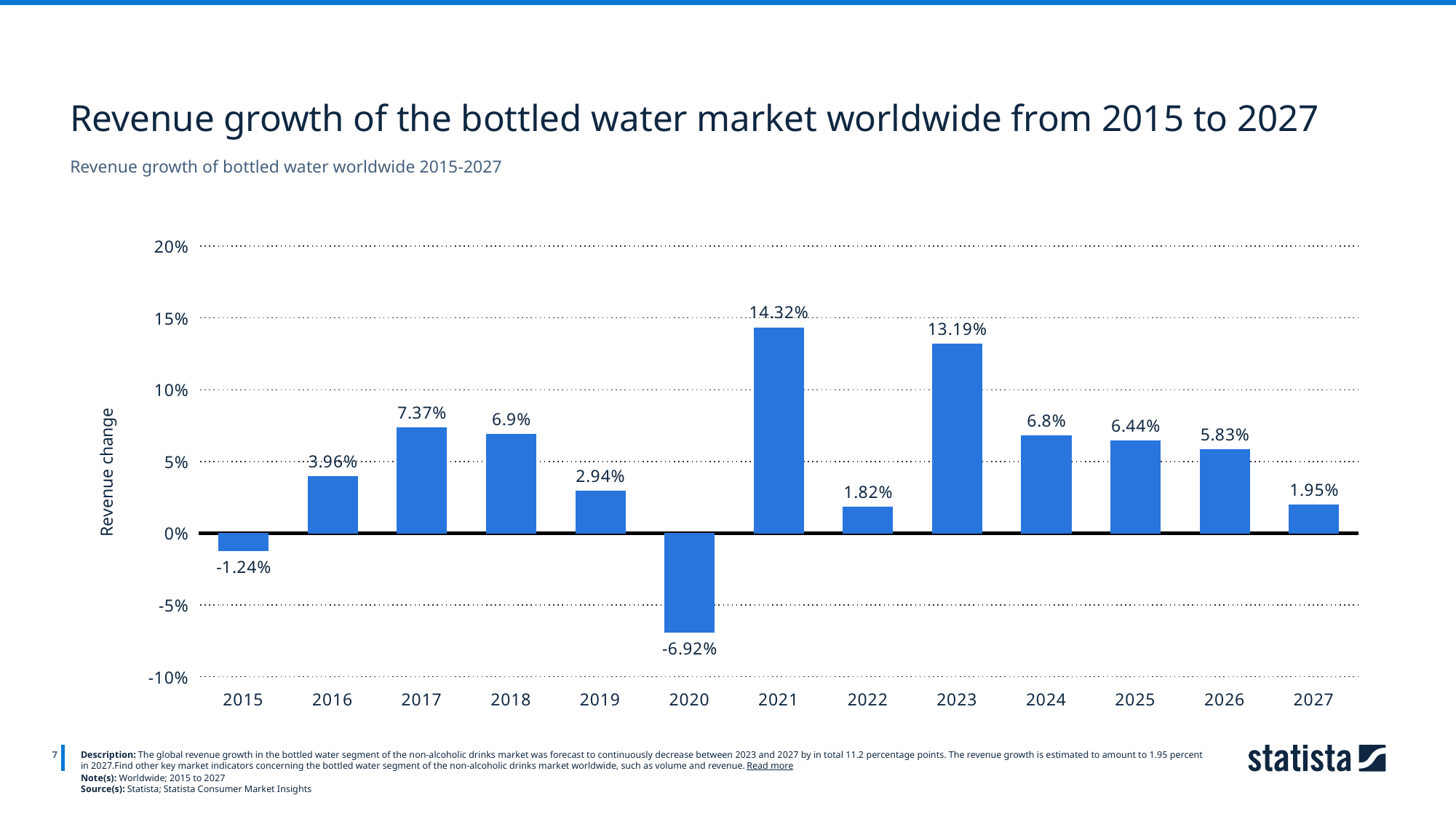
What is the revenue growth of the bottled water market worldwide in 2021? 14.32% Which year has the highest revenue growth? 2021 How many years are shown on the x axis of the chart? 13 Is the value for 2023 greater or less than 10%? greater What kind of chart is shown on the slide? Bar chart Which year has higher revenue growth, 2017 or 2018? 2017 What is the label of the y axis? Revenue change What is the revenue growth value shown for 2020? -6.92% Which year has the lowest revenue growth? 2020 What is the revenue growth value shown for 2027? 1.95% What is the difference in revenue growth between 2021 and 2023? 1.13 percentage points Do the values rise or fall from 2023 to 2027? Fall